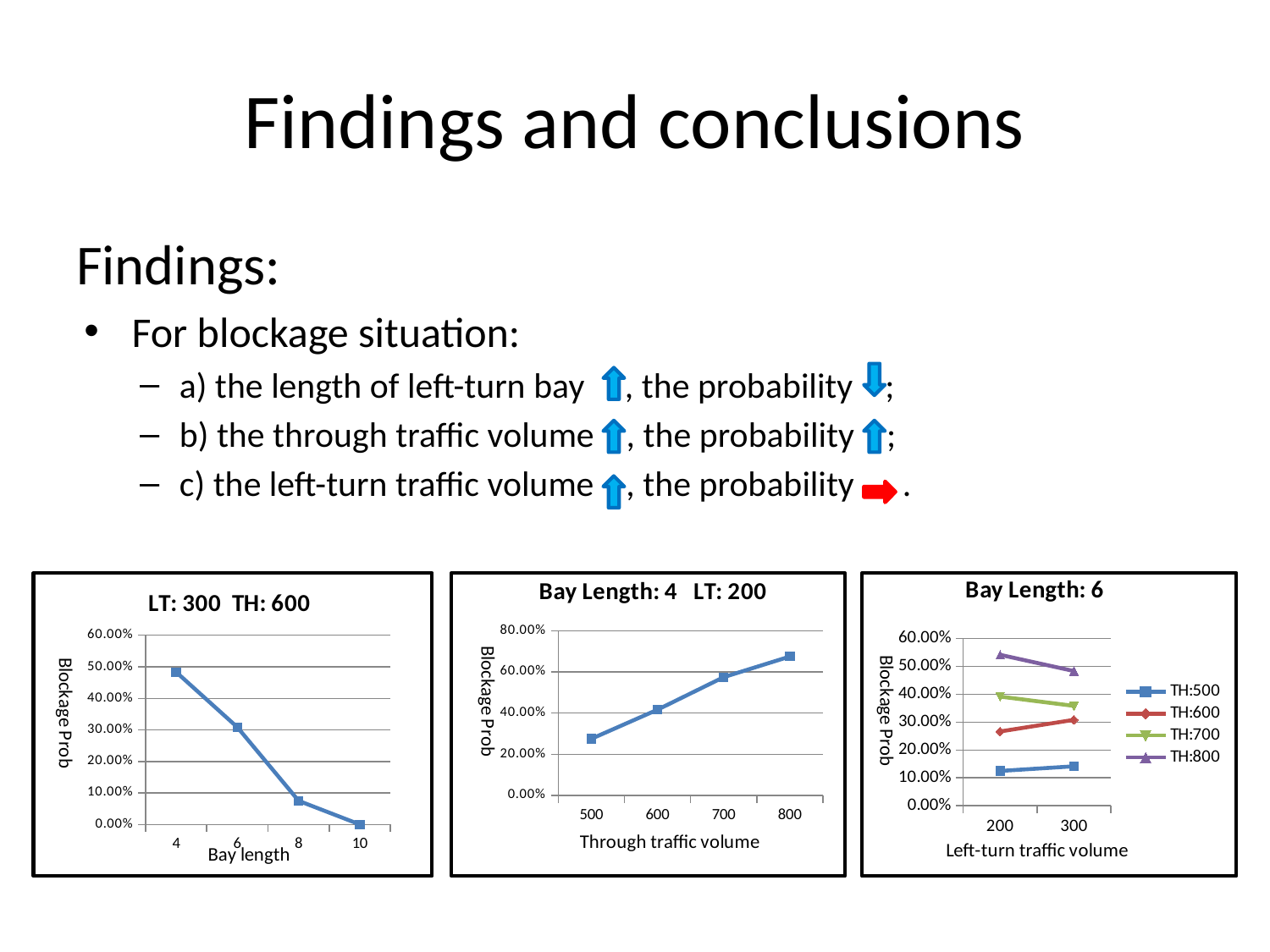
In the chart titled "LT: 300 TH: 600", does the blockage probability rise or fall as bay length increases? fall In the chart titled "LT: 300 TH: 600", what kind of chart is shown? line chart In the chart titled "Bay Length: 4 LT: 200", which through traffic volume has the lowest blockage probability? 500 In the chart titled "Bay Length: 6", is the blockage probability for TH:500 at left-turn traffic volume 200 greater or less than 20.00%? less In the chart titled "LT: 300 TH: 600", which bay length has the highest blockage probability? 4 In the chart titled "Bay Length: 4 LT: 200", is the blockage probability at through traffic volume 800 greater or less than 60.00%? greater In the chart titled "Bay Length: 6", how many series does the legend list? 4 In the chart titled "Bay Length: 4 LT: 200", does the blockage probability rise or fall as through traffic volume increases? rise In the chart titled "LT: 300 TH: 600", how many bay length values are plotted on the x axis? 4 In the chart titled "LT: 300 TH: 600", is the blockage probability for bay length 4 greater or less than 40.00%? greater In the chart titled "Bay Length: 6", which series has the highest blockage probability at left-turn traffic volume 200? TH:800 In the chart titled "Bay Length: 6", what is the label of the x axis? Left-turn traffic volume